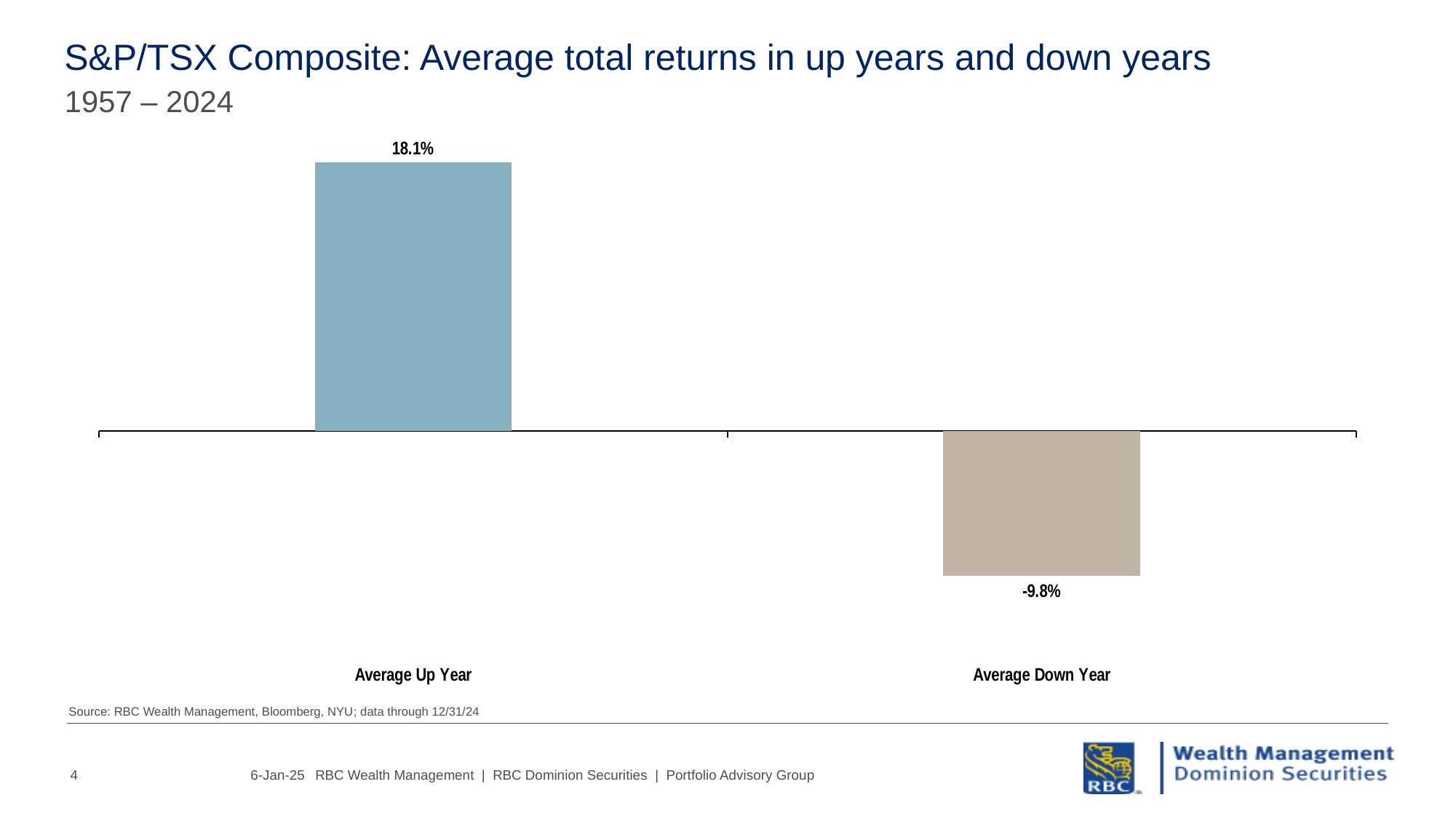
What period does the chart cover, according to the subtitle? 1957 – 2024 How many categories are shown in the chart? 2 Which category has the lowest value? Average Down Year What kind of chart is shown on the slide? Bar chart What is the value for Average Up Year? 18.1% Which is larger, the value for Average Up Year or Average Down Year? Average Up Year What is the difference between the Average Up Year and Average Down Year values? 27.9 percentage points What is the value for Average Down Year? -9.8% Is the value for Average Down Year positive or negative? Negative What is the title of the chart? S&P/TSX Composite: Average total returns in up years and down years Which category has the highest value? Average Up Year